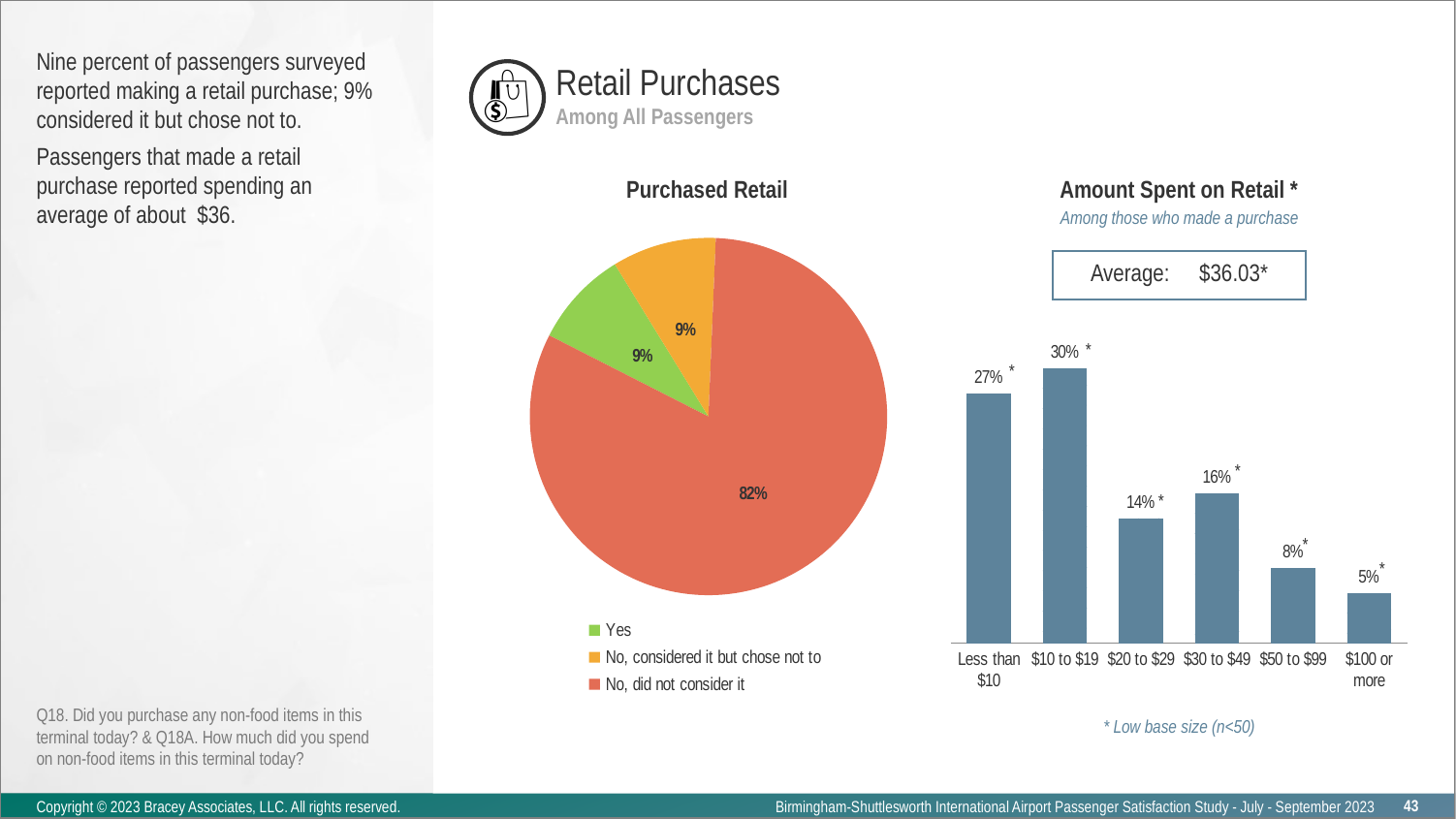
In the Amount Spent on Retail chart, what percentage spent $100 or more? 5% In the Purchased Retail pie chart, what share of passengers answered "No, did not consider it"? 82% What type of chart is the Purchased Retail chart? Pie chart In the Amount Spent on Retail chart, which spending category has the highest percentage? $10 to $19 In the Amount Spent on Retail chart, which is larger: the percentage for $20 to $29 or for $30 to $49? $30 to $49 In the Amount Spent on Retail chart, what is the difference between the percentages for Less than $10 and $50 to $99? 19 percentage points In the Purchased Retail pie chart, which category has the largest slice? No, did not consider it In the Amount Spent on Retail chart, which spending category has the lowest percentage? $100 or more In the Purchased Retail pie chart, what percentage of passengers answered "Yes"? 9% In the Purchased Retail pie chart, how many categories does the legend list? 3 In the Amount Spent on Retail chart, what percentage spent $10 to $19? 30% In the Amount Spent on Retail chart, how many spending categories are shown? 6